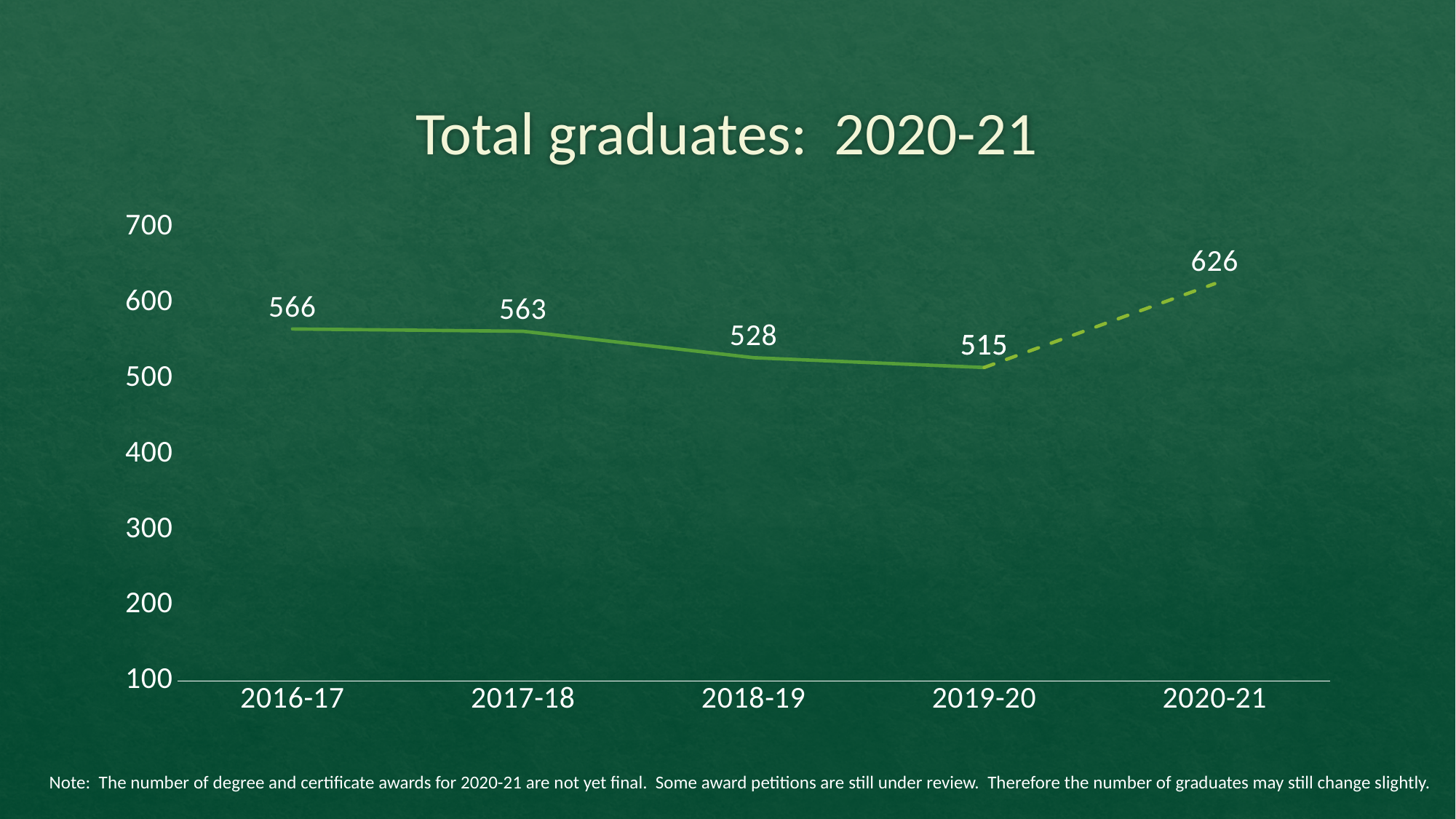
Which year has the lowest number of graduates? 2019-20 What kind of chart is shown on the slide? line chart What is the difference between the values for 2020-21 and 2019-20? 111 How many years are plotted on the chart? 5 What is the value for 2020-21? 626 What is the title of the chart? Total graduates: 2020-21 What is the difference between the values for 2016-17 and 2018-19? 38 Which is larger, the value for 2017-18 or the value for 2019-20? 2017-18 Is the value for 2020-21 greater or less than 600? greater What is the value for 2016-17? 566 What is the value for 2018-19? 528 Which year has the highest number of graduates? 2020-21